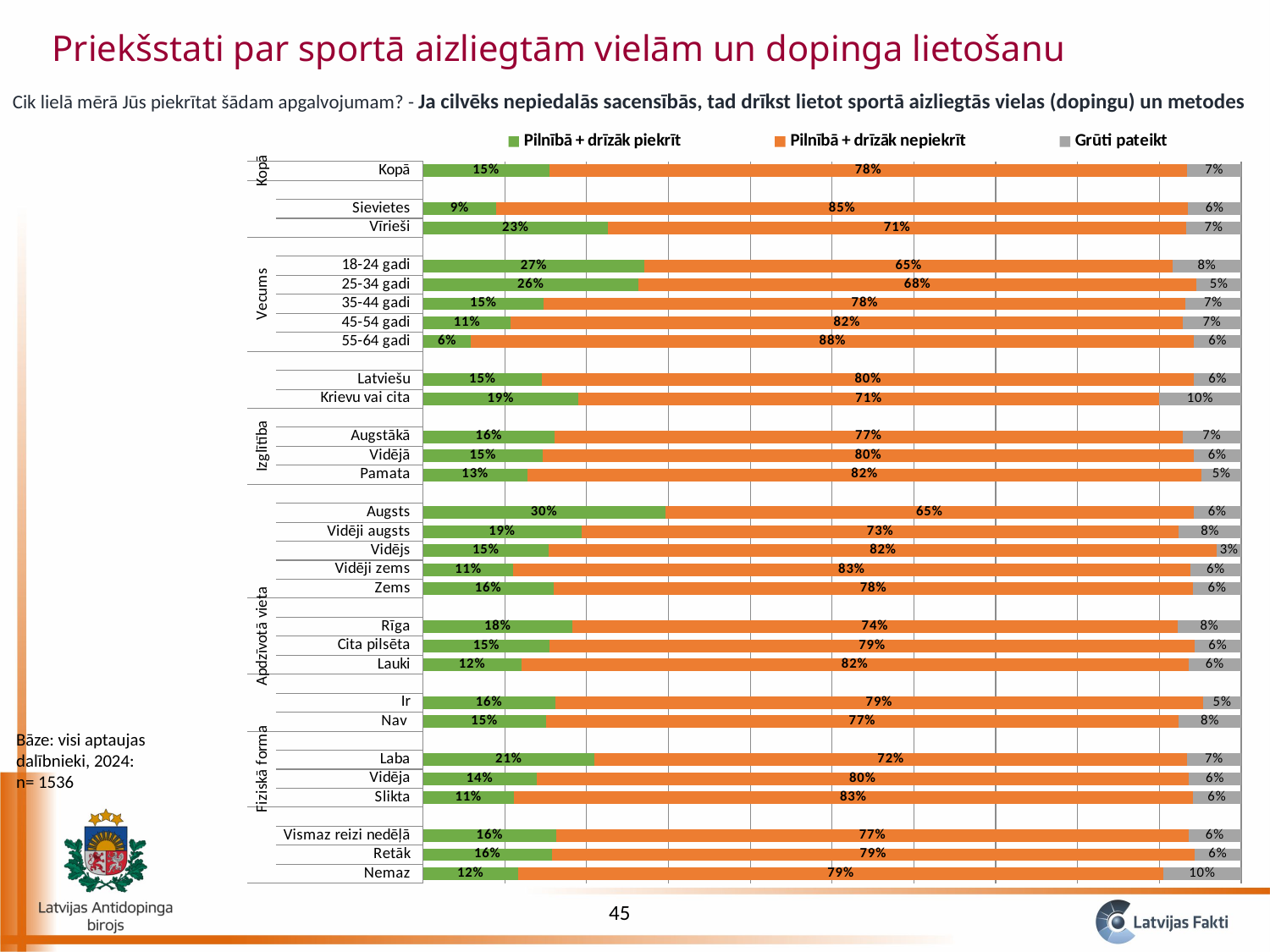
Which has a larger "Pilnībā + drīzāk nepiekrīt" value, Rīga or Lauki? Lauki What is the "Grūti pateikt" value for Vidējs? 3% What is the "Pilnībā + drīzāk piekrīt" value for 18-24 gadi? 27% Which category has the highest "Pilnībā + drīzāk nepiekrīt" value? 55-64 gadi What is the "Grūti pateikt" value for Krievu vai cita? 10% Which category has the highest "Pilnībā + drīzāk piekrīt" value? Augsts What is the "Pilnībā + drīzāk nepiekrīt" value for Kopā? 78% What kind of chart is shown on the slide? bar chart What is the difference between the "Pilnībā + drīzāk piekrīt" values for Vīrieši and Sievietes? 14% What is the "Pilnībā + drīzāk piekrīt" value for Sievietes? 9% Which category has the lowest "Pilnībā + drīzāk piekrīt" value? 55-64 gadi How many series does the legend list? 3